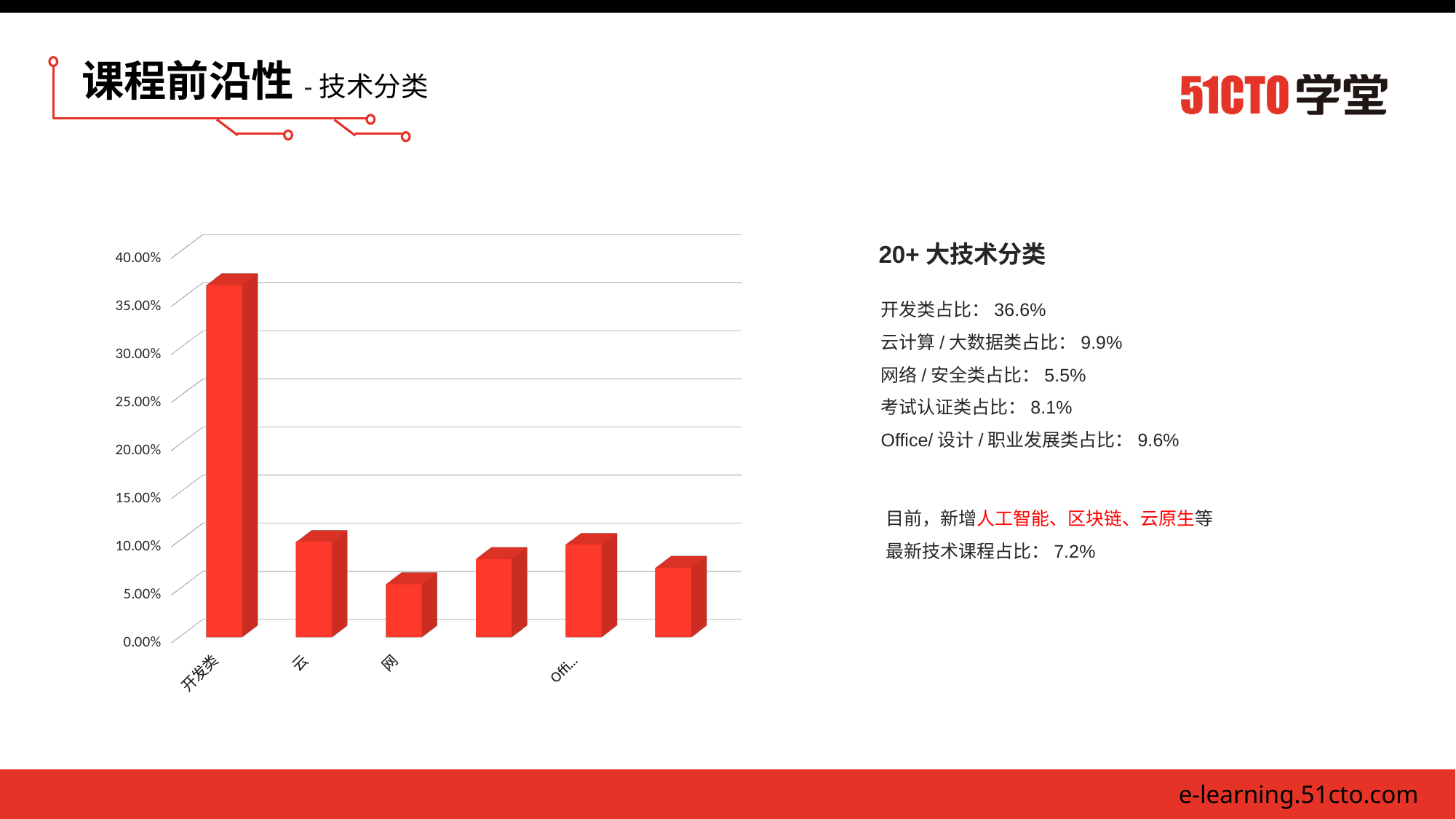
Is the value for 开发类 greater or less than 30.00%? greater Which is larger, the bar for 云 or the bar for 网? 云 How many bars does the chart show? 6 What colour are the bars in the chart? red What kind of chart is shown on the slide? bar chart Is the value for Offi... greater or less than 20.00%? less Is the value for 网 greater or less than 10.00%? less Which labelled category has the lowest bar in the chart? 网 Which category has the highest bar in the chart? 开发类 What is the share for 开发类 according to the slide? 36.6% Does the value rise or fall from 开发类 to 云? fall